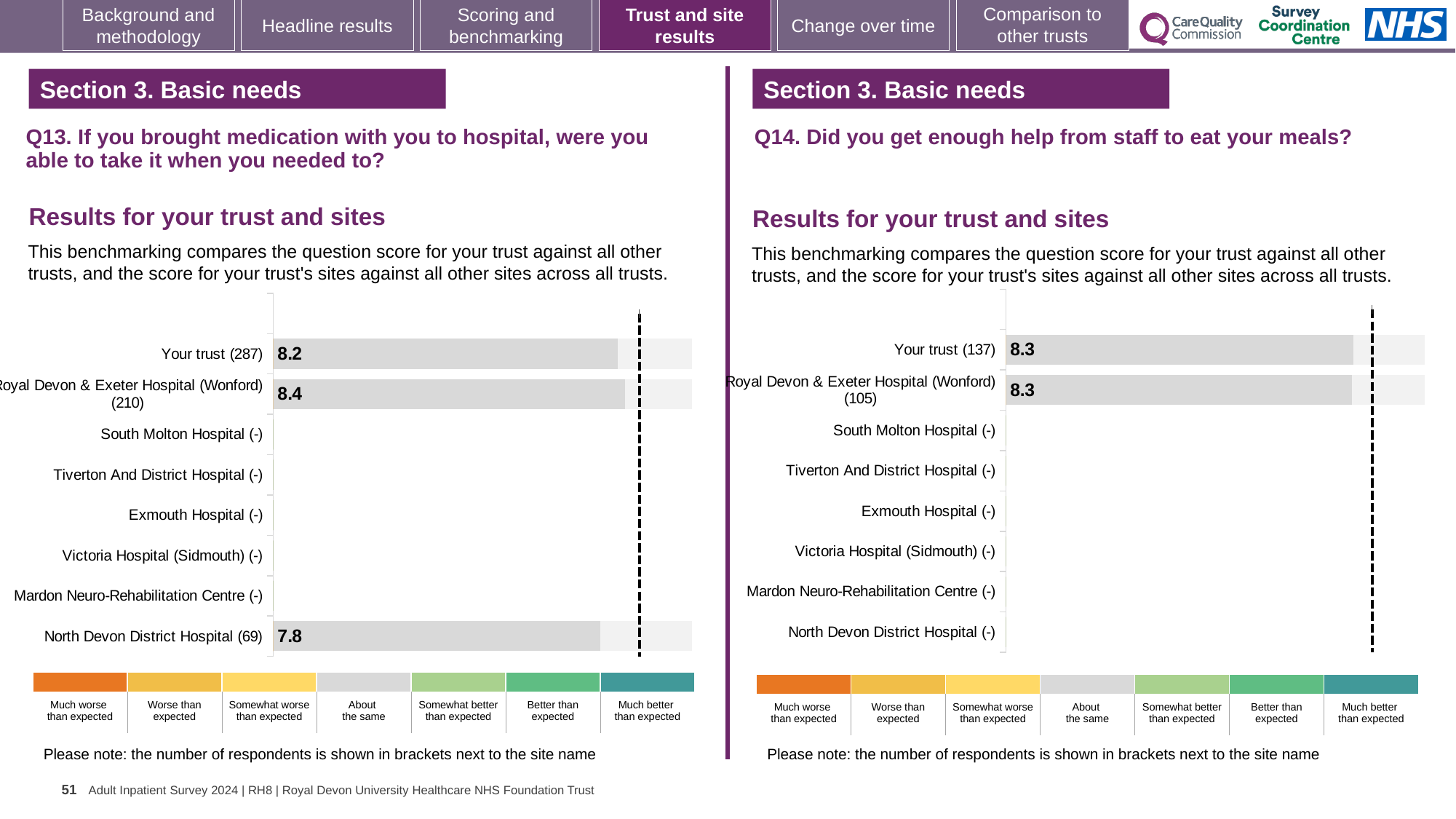
In the Q13 chart on the left, what is the score for North Devon District Hospital (69)? 7.8 What type of chart is used for the Q13 results on the left? Bar chart In the Q13 chart on the left, how many respondents are shown in brackets for Your trust? 287 In the Q13 chart on the left, which site or trust row has the highest score? Royal Devon & Exeter Hospital (Wonford) (210) In the Q14 chart on the right, what is the score for Your trust (137)? 8.3 In the Q13 chart on the left, which is larger: the score for Your trust or the score for North Devon District Hospital? Your trust How many site or trust rows are listed on the y axis of the Q14 chart on the right? 8 In the Q13 chart on the left, what is the difference between the score for Royal Devon & Exeter Hospital (Wonford) and the score for North Devon District Hospital? 0.6 In the Q13 chart on the left, which site or trust row has the lowest plotted score? North Devon District Hospital (69) In the Q14 chart on the right, what is the score for Royal Devon & Exeter Hospital (Wonford) (105)? 8.3 In the Q13 chart on the left, what is the score for Royal Devon & Exeter Hospital (Wonford) (210)? 8.4 In the Q13 chart on the left, what is the score for Your trust (287)? 8.2